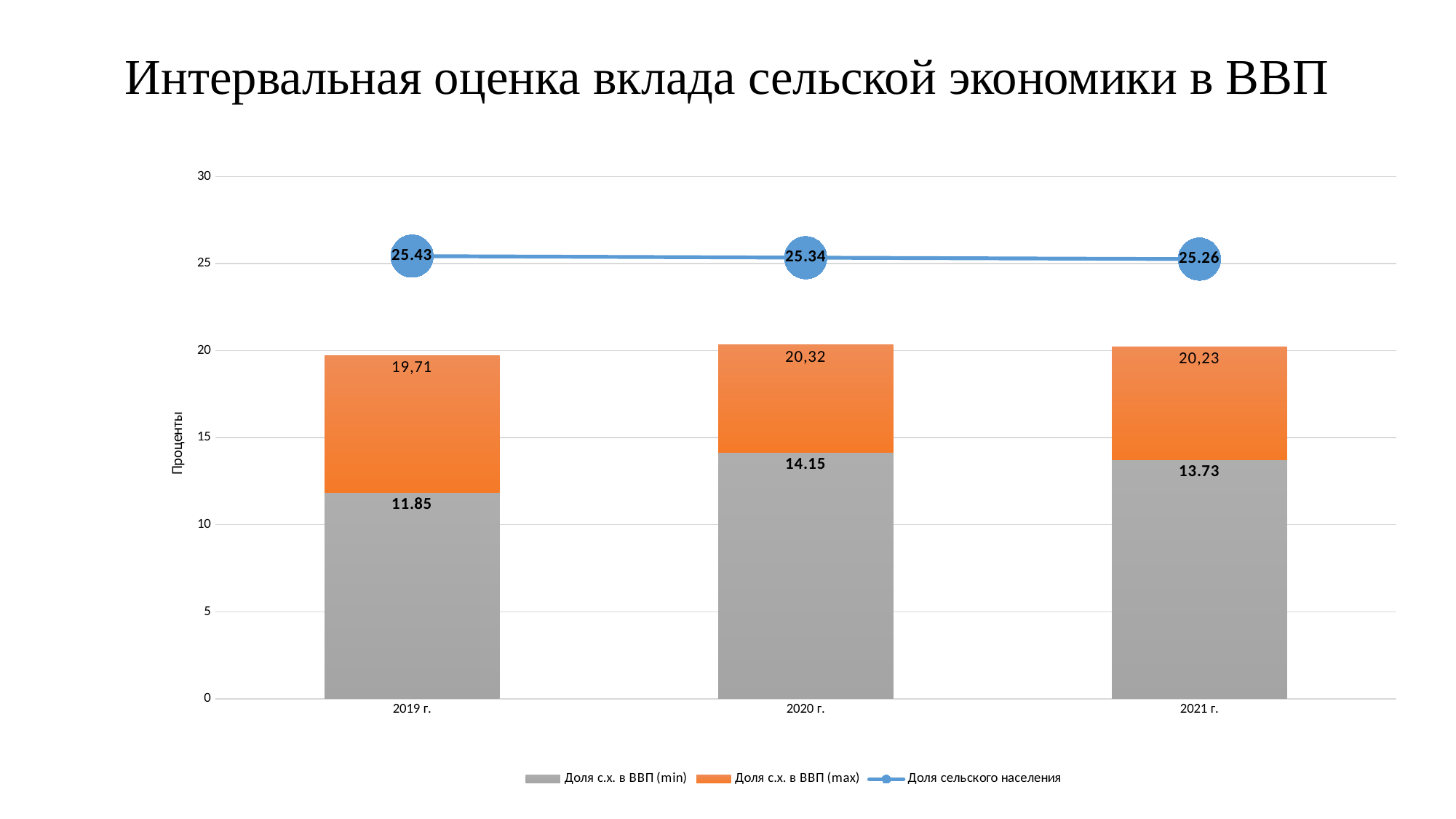
How many years are shown on the x axis? 3 What is the value labelled for Доля с.х. в ВВП (min) in 2019 г.? 11.85 What is the value of Доля сельского населения in 2021 г.? 25.26 Does Доля сельского населения rise or fall from 2019 г. to 2021 г.? fall In which year is Доля сельского населения highest? 2019 г. What is the difference between Доля с.х. в ВВП (min) in 2020 г. and in 2019 г.? 2.30 What is the value labelled for Доля с.х. в ВВП (max) in 2021 г.? 20,23 How many series does the legend list? 3 Which is larger: Доля с.х. в ВВП (min) in 2021 г. or in 2019 г.? 2021 г. In which year is Доля с.х. в ВВП (min) lowest? 2019 г. In which year is Доля с.х. в ВВП (min) highest? 2020 г. What is the value labelled for Доля с.х. в ВВП (max) in 2020 г.? 20,32